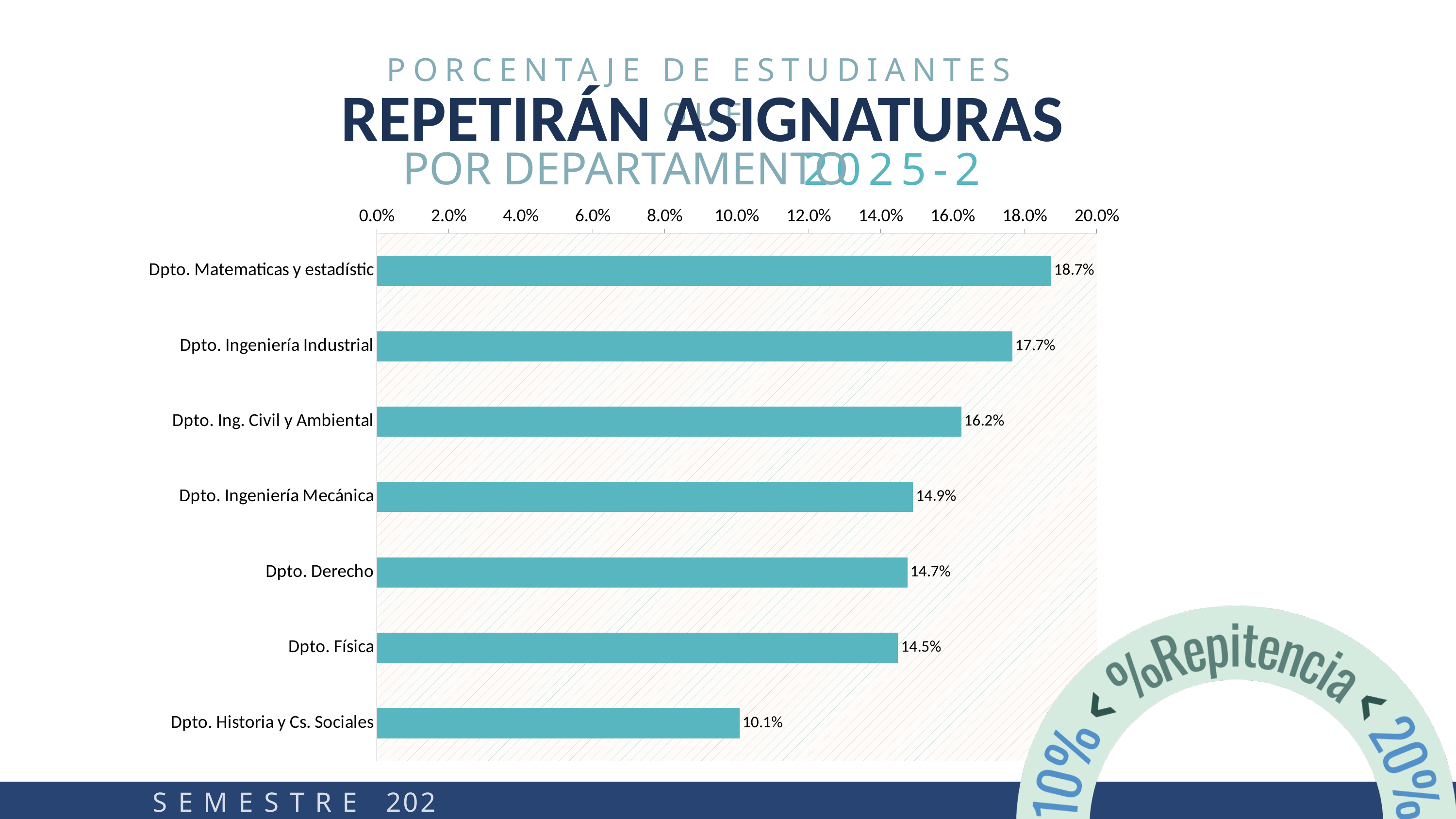
What is the value for Dpto. Derecho? 14.7% Is the value for Dpto. Ingeniería Mecánica greater or less than 12.0%? greater What is the maximum value shown on the horizontal axis? 20.0% What is the difference between Dpto. Matematicas y estadístic and Dpto. Historia y Cs. Sociales? 8.6% What is the difference between Dpto. Ingeniería Industrial and Dpto. Ing. Civil y Ambiental? 1.5% Which department has the lowest percentage? Dpto. Historia y Cs. Sociales Which department has the highest percentage? Dpto. Matematicas y estadístic How many departments are shown in the chart? 7 What kind of chart is shown on the slide? bar chart Which is larger, the value for Dpto. Ing. Civil y Ambiental or Dpto. Física? Dpto. Ing. Civil y Ambiental What is the value for Dpto. Ingeniería Industrial? 17.7% What is the value for Dpto. Historia y Cs. Sociales? 10.1%